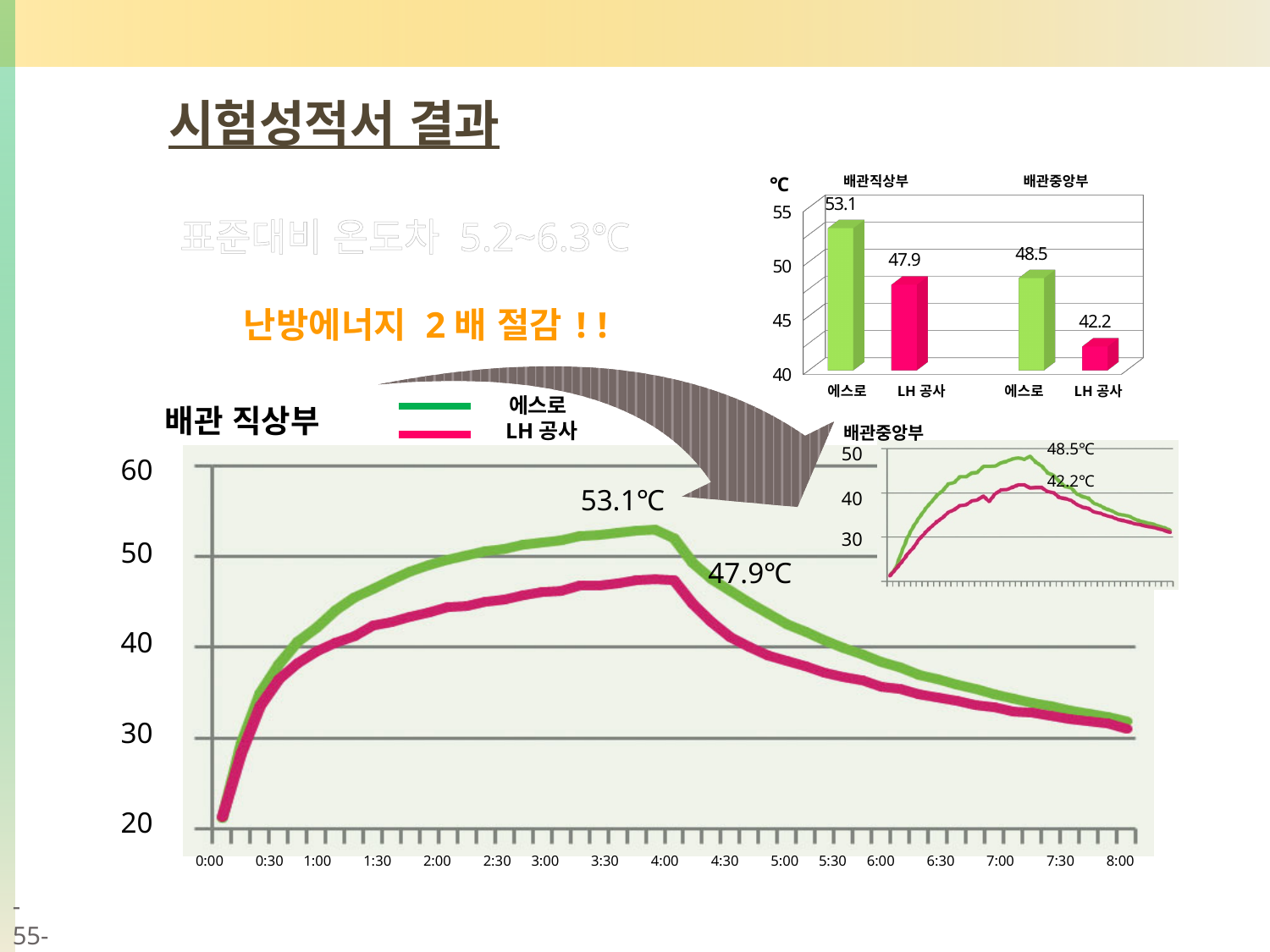
In the bar chart at the top right, which bar is the lowest? LH 공사 (배관중앙부) In the bar chart at the top right, what is the value for 에스로 in the 배관직상부 group? 53.1 In the large 배관 직상부 line chart, do the values rise or fall between 4:00 and 8:00? fall In the large 배관 직상부 line chart, how many series does the legend list? 2 In the bar chart at the top right, what is the difference between 에스로 and LH 공사 in the 배관직상부 group? 5.2 What kind of chart is the chart at the top right of the slide? bar chart In the large 배관 직상부 line chart, what peak temperature is labelled for the LH 공사 line? 47.9℃ In the bar chart at the top right, how many bars are plotted? 4 In the large 배관 직상부 line chart, what peak temperature is labelled for the 에스로 line? 53.1℃ In the bar chart at the top right, what is the difference between 에스로 and LH 공사 in the 배관중앙부 group? 6.3 In the bar chart at the top right, what is the value for LH 공사 in the 배관중앙부 group? 42.2 In the small 배관중앙부 line chart, which of the two labelled peak values is larger, 48.5℃ or 42.2℃? 48.5℃